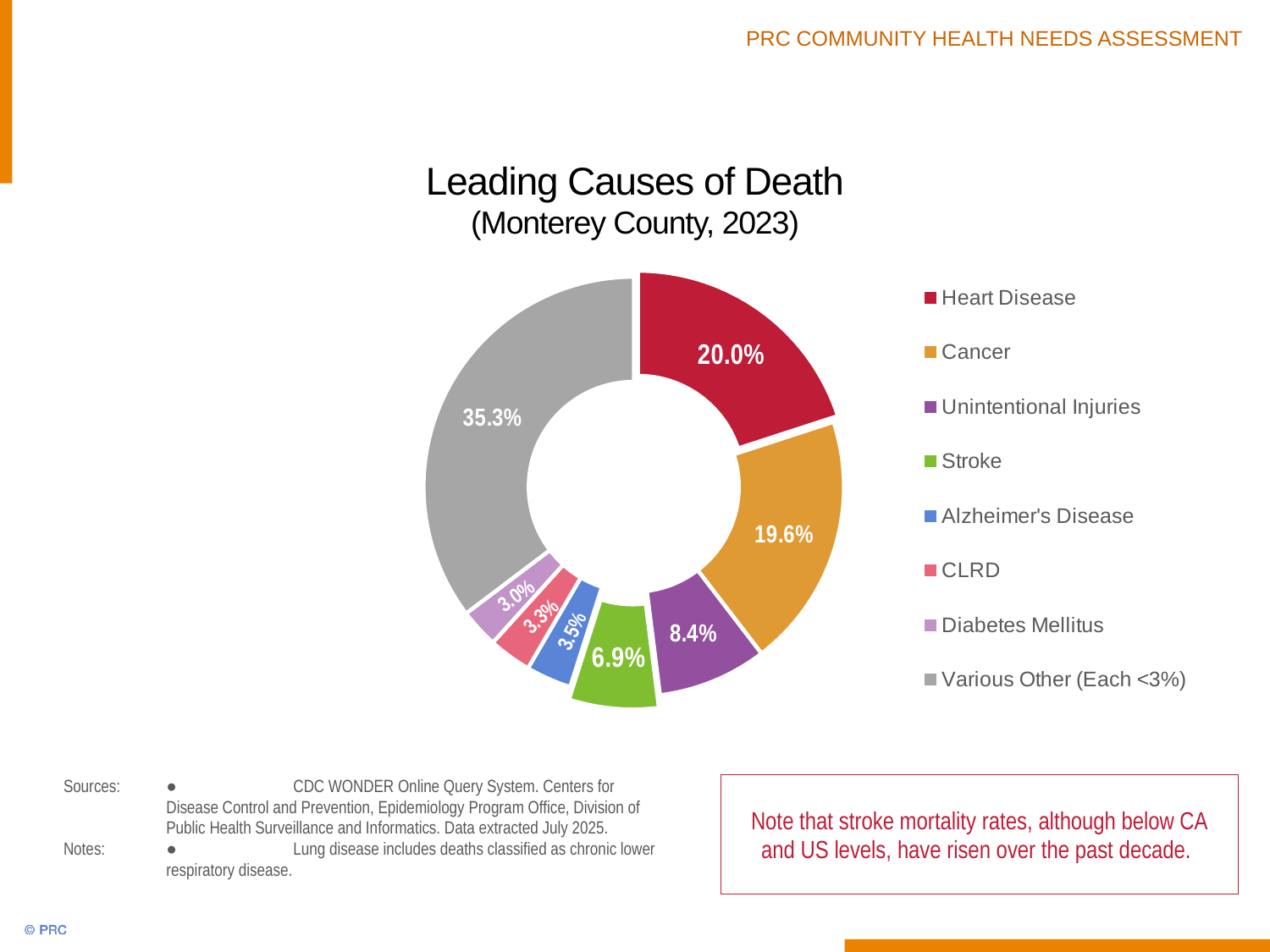
What type of chart is shown on the slide? Doughnut chart What percentage is shown for Alzheimer's Disease? 3.5% What is the value shown for Stroke? 6.9% Which is larger, the share for Heart Disease or the share for Cancer? Heart Disease What is the difference in percentage points between Unintentional Injuries and Stroke? 1.5 What is the difference in percentage points between Heart Disease and Cancer? 0.4 How many categories are shown in the chart? 8 Which category has the largest slice of the pie? Various Other (Each <3%) What share of deaths is attributed to Heart Disease? 20.0% What percentage of the pie is Cancer? 19.6% Which category has the smallest slice of the pie? Diabetes Mellitus What is the title of the chart? Leading Causes of Death (Monterey County, 2023)